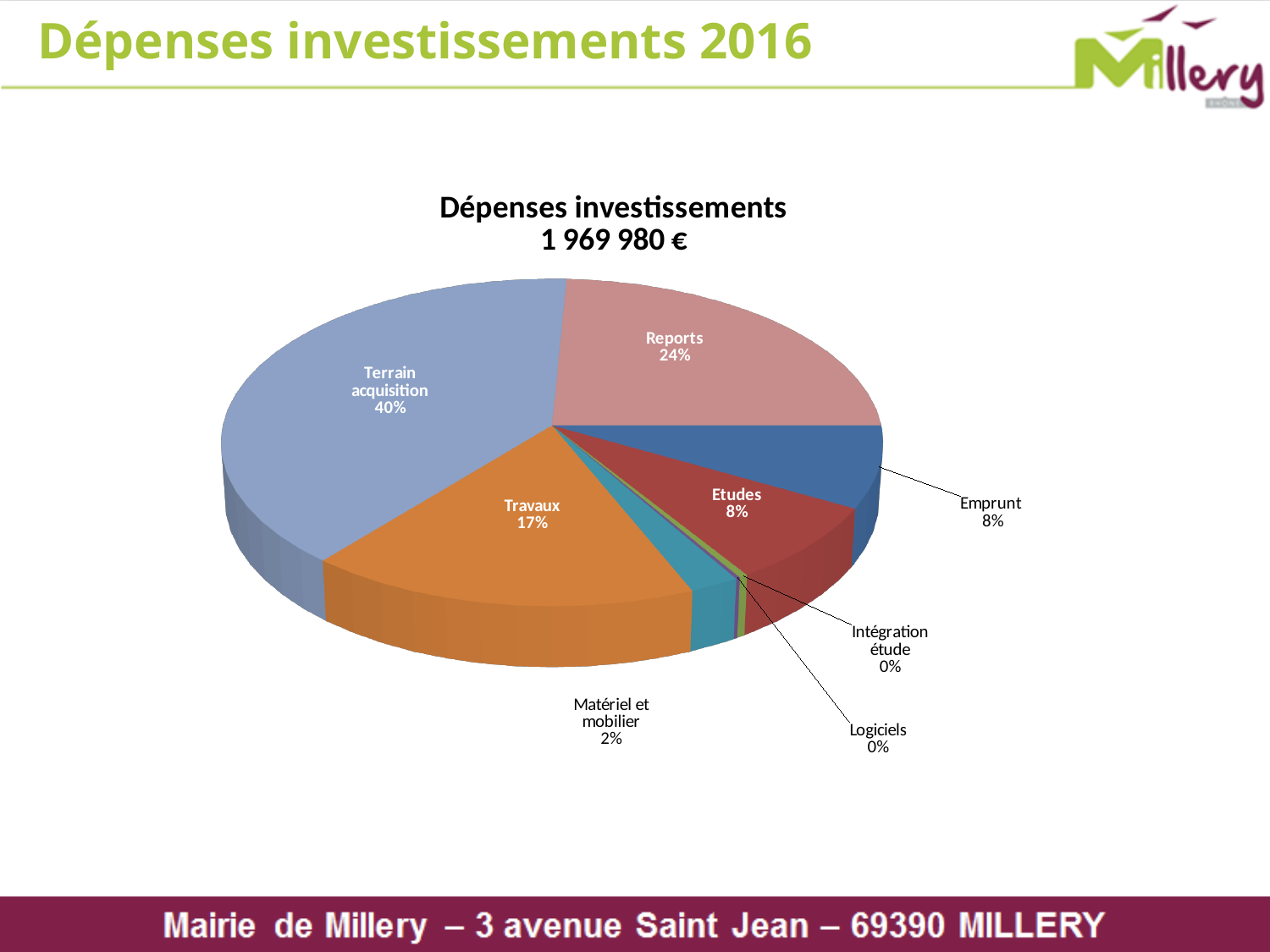
What is the difference in percentage points between Reports and Travaux? 7 What is the difference in percentage points between Terrain acquisition and Reports? 16 What percentage is shown for Matériel et mobilier? 2% What percentage is shown for Travaux? 17% What percentage is shown for Logiciels? 0% What kind of chart is shown on the slide? pie chart Which is larger, the share for Travaux or the share for Etudes? Travaux What total amount is shown in the chart title? 1 969 980 € Which category has the largest slice of the pie? Terrain acquisition What percentage is shown for Reports? 24% How many categories are labelled on the pie chart? 8 What share of the pie does Terrain acquisition represent? 40%